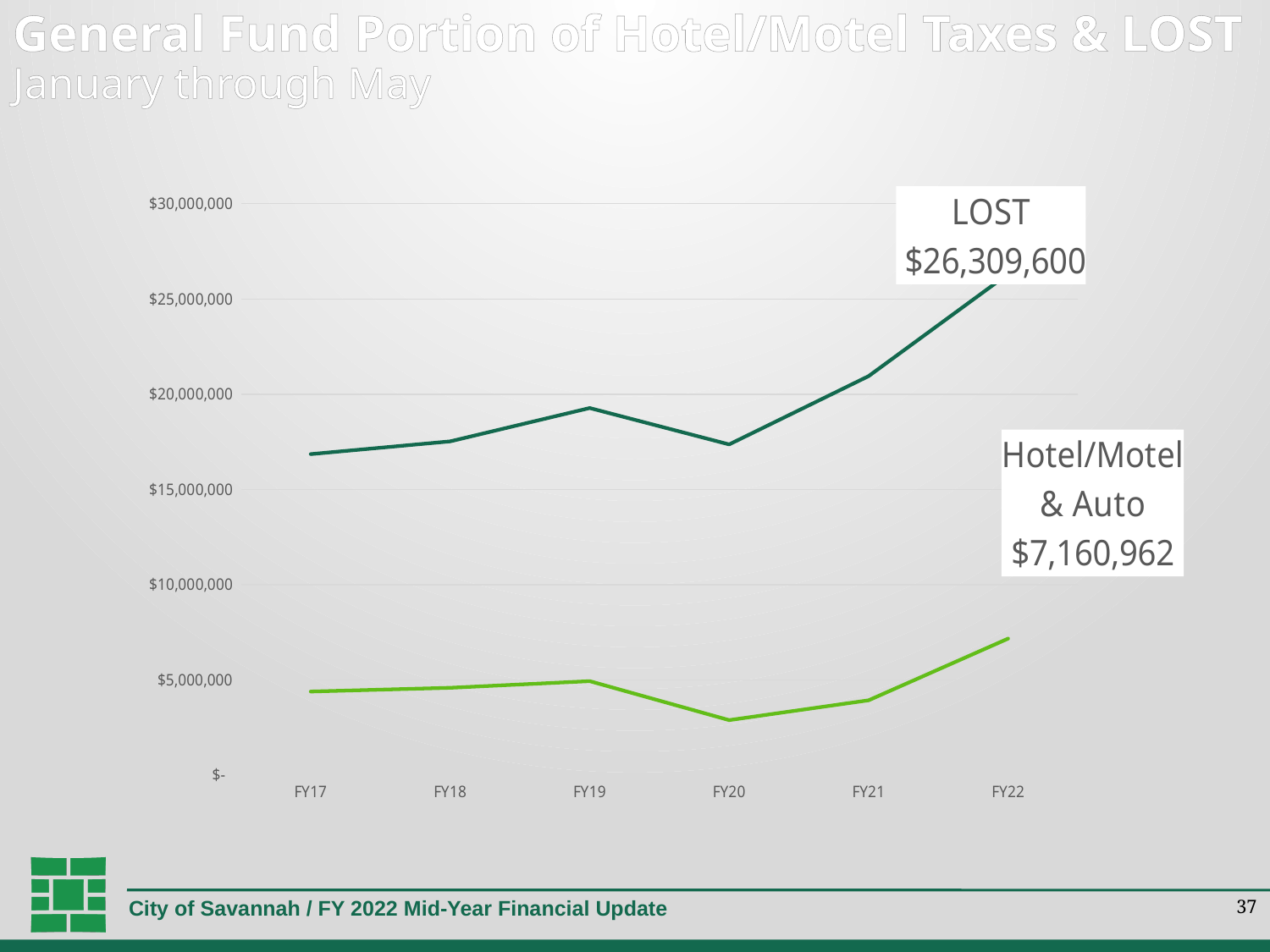
In which fiscal year is the Hotel/Motel & Auto series at its lowest? FY20 Is the LOST value for FY17 greater or less than $20,000,000? less How many fiscal years are shown on the x axis? 6 Which is larger for the LOST series, the FY19 value or the FY20 value? FY19 How many data series are plotted on the chart? 2 Is the Hotel/Motel & Auto value for FY20 greater or less than $5,000,000? less What is the value of the LOST series in FY22? $26,309,600 Does the LOST series rise or fall from FY20 to FY22? Rise What is the difference between the LOST value and the Hotel/Motel & Auto value in FY22? $19,148,638 What is the value of the Hotel/Motel & Auto series in FY22? $7,160,962 In which fiscal year is the LOST series at its highest? FY22 What kind of chart is shown on the slide? Line chart